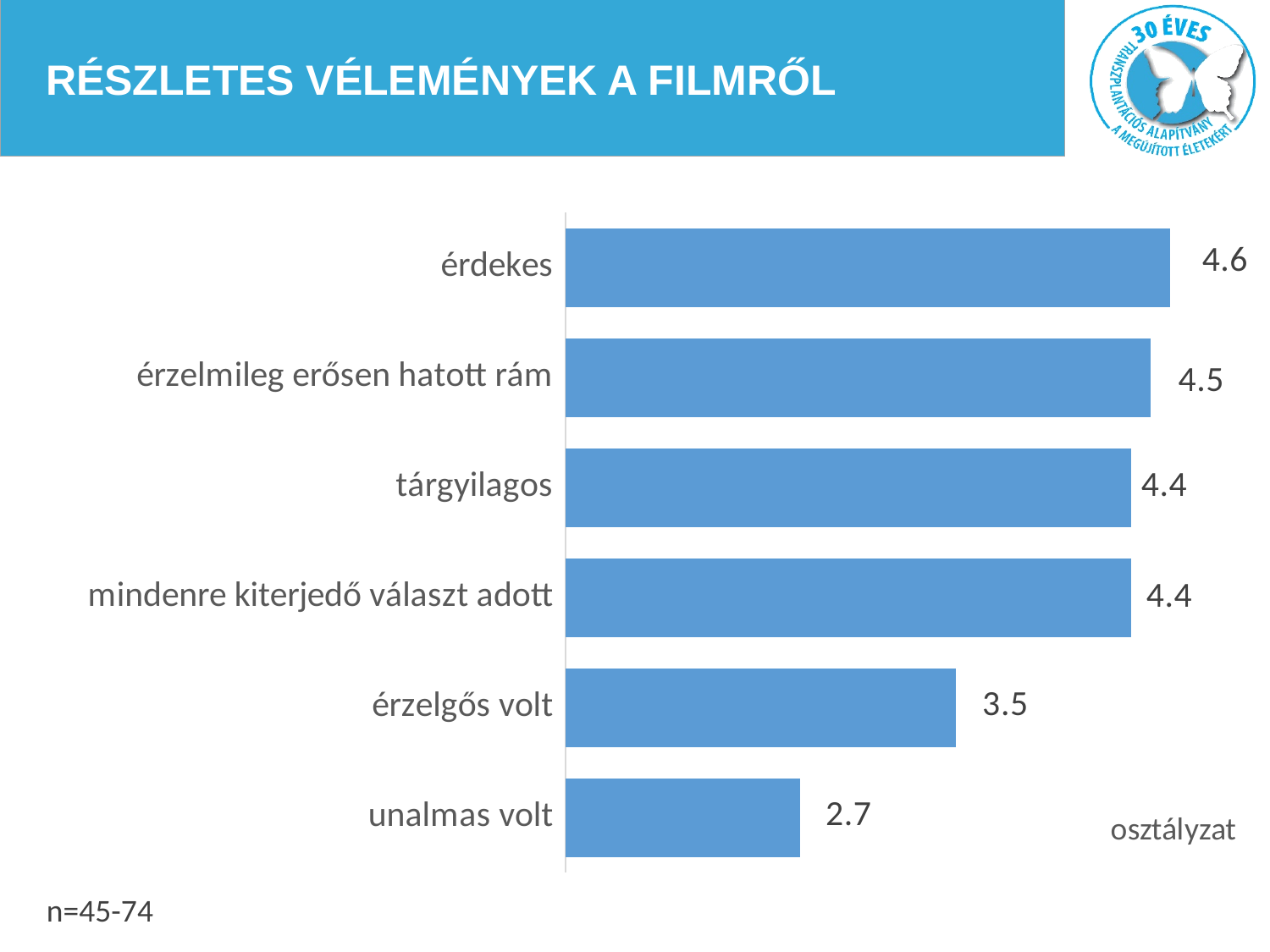
What kind of chart is shown on the slide? bar chart Which category has the lowest value? unalmas volt How many categories are shown in the chart? 6 What is the value for "érdekes"? 4.6 What is the sample size noted at the bottom of the slide? n=45-74 What is the value for "unalmas volt"? 2.7 Which is larger, the value for "érzelgős volt" or the value for "unalmas volt"? érzelgős volt What is the value for "érzelmileg erősen hatott rám"? 4.5 What is the difference between the values for "tárgyilagos" and "érzelgős volt"? 0.9 What is the difference between the values for "érdekes" and "unalmas volt"? 1.9 Which category has the highest value? érdekes What is the value for "érzelgős volt"? 3.5